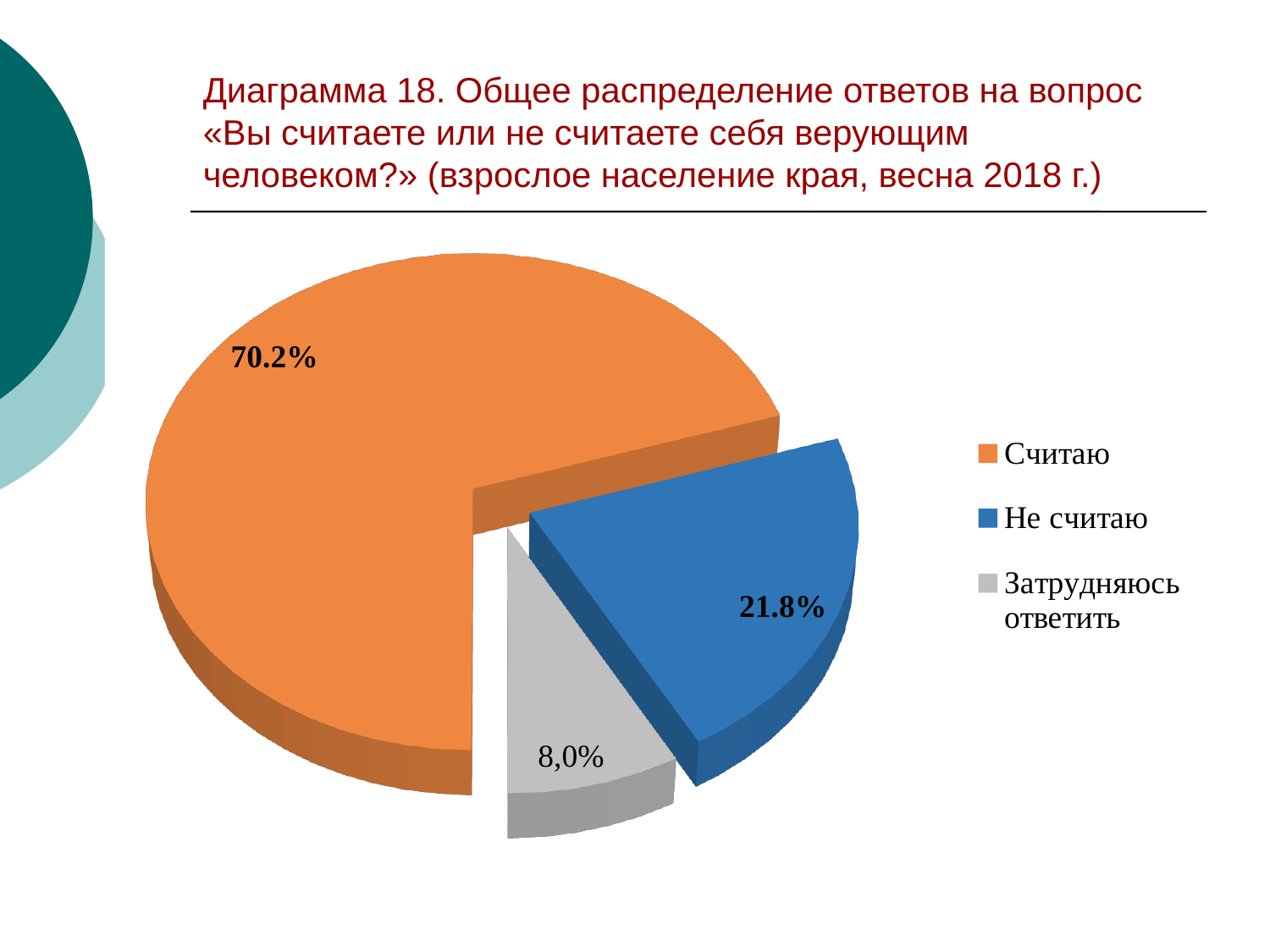
How many entries does the legend list? 3 What colour is the slice for «Считаю»? orange Which answer has the smallest share of the pie? Затрудняюсь ответить What is the difference in percentage points between the «Считаю» and «Не считаю» shares? 48.4 What type of chart is shown on the slide? pie chart What share of respondents answered «Считаю»? 70.2% What share of respondents answered «Не считаю»? 21.8% What share of respondents answered «Затрудняюсь ответить»? 8,0% Which is larger: the share for «Не считаю» or the share for «Затрудняюсь ответить»? Не считаю How many slices does the pie chart have? 3 What colour is the slice for «Не считаю»? blue Which answer has the largest share of the pie? Считаю